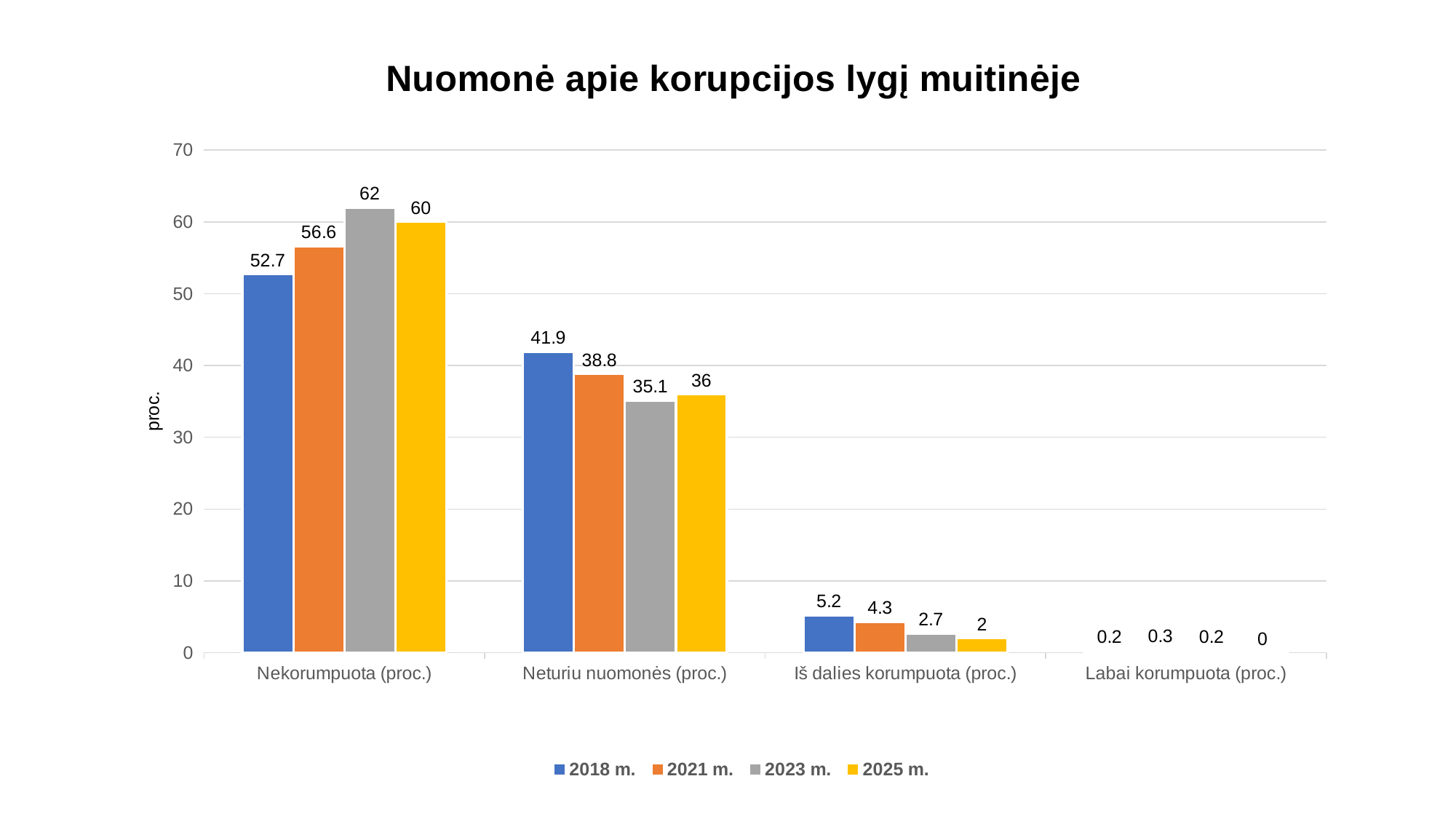
What is the value for 2021 m. in the Labai korumpuota (proc.) category? 0.3 What is the value for 2025 m. in the Iš dalies korumpuota (proc.) category? 2 What is the value for 2023 m. in the Nekorumpuota (proc.) category? 62 Which year has the highest value in the Nekorumpuota (proc.) category? 2023 m. How many series does the legend list? 4 Which is larger in the Iš dalies korumpuota (proc.) category: the 2018 m. value or the 2021 m. value? 2018 m. What kind of chart is shown on the slide? Bar chart Which year has the lowest value in the Neturiu nuomonės (proc.) category? 2023 m. What is the title of the chart? Nuomonė apie korupcijos lygį muitinėje What is the value for 2018 m. in the Neturiu nuomonės (proc.) category? 41.9 What is the difference between the 2025 m. and 2018 m. values in the Nekorumpuota (proc.) category? 7.3 How many categories are shown on the x axis? 4